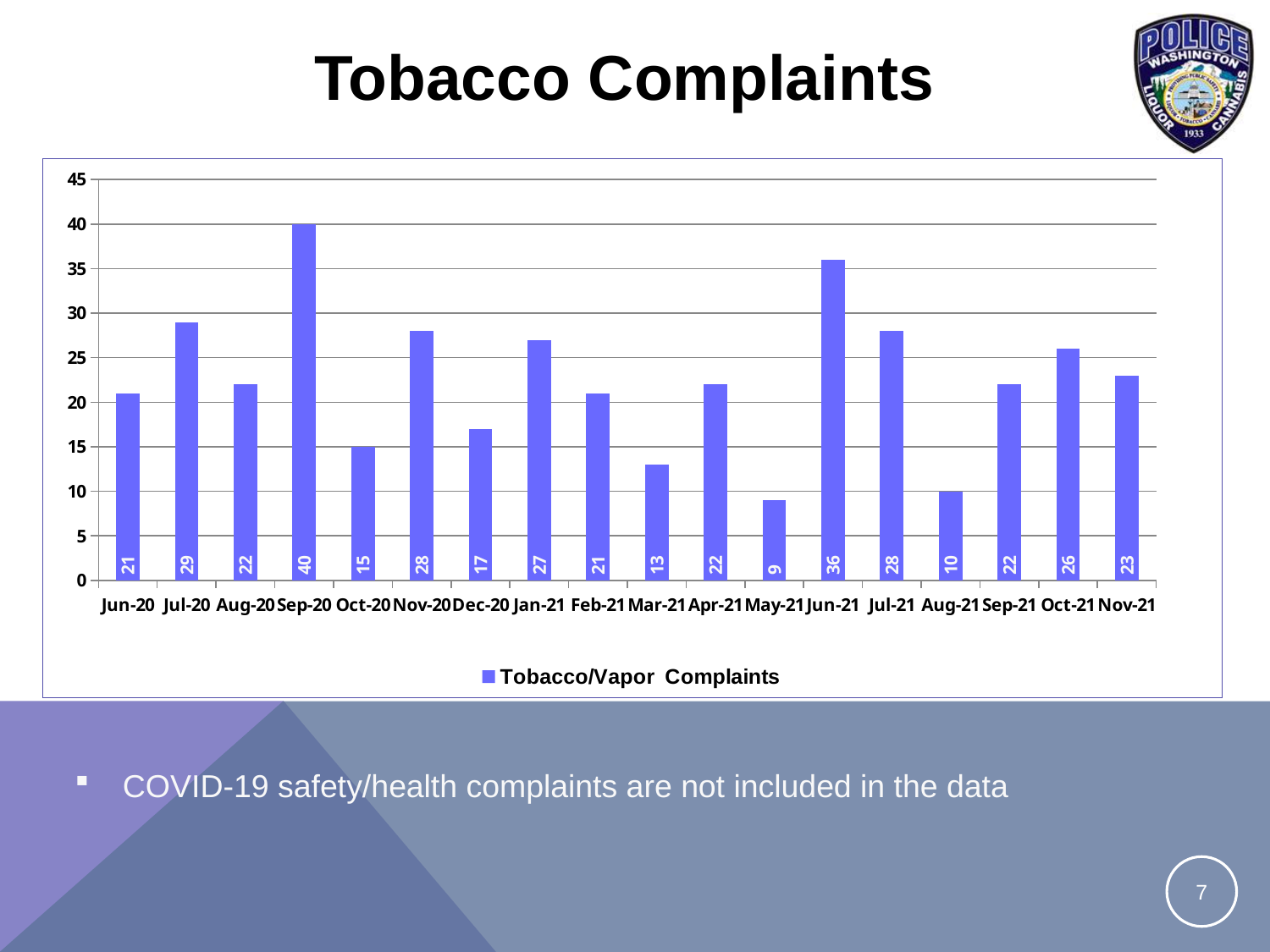
Is the value for Jan-21 greater or less than 25? greater How many months are shown on the x axis? 18 What is the legend entry for the series shown? Tobacco/Vapor Complaints What is the value for Jun-21? 36 What is the difference between the values for Sep-20 and Oct-20? 25 Which month has the highest number of Tobacco/Vapor Complaints? Sep-20 How many series does the legend list? 1 What kind of chart is shown on the slide? bar chart What is the value for May-21? 9 What is the value for Sep-20? 40 Which is larger, the value for Jul-20 or the value for Jul-21? Jul-20 Which month has the lowest number of Tobacco/Vapor Complaints? May-21